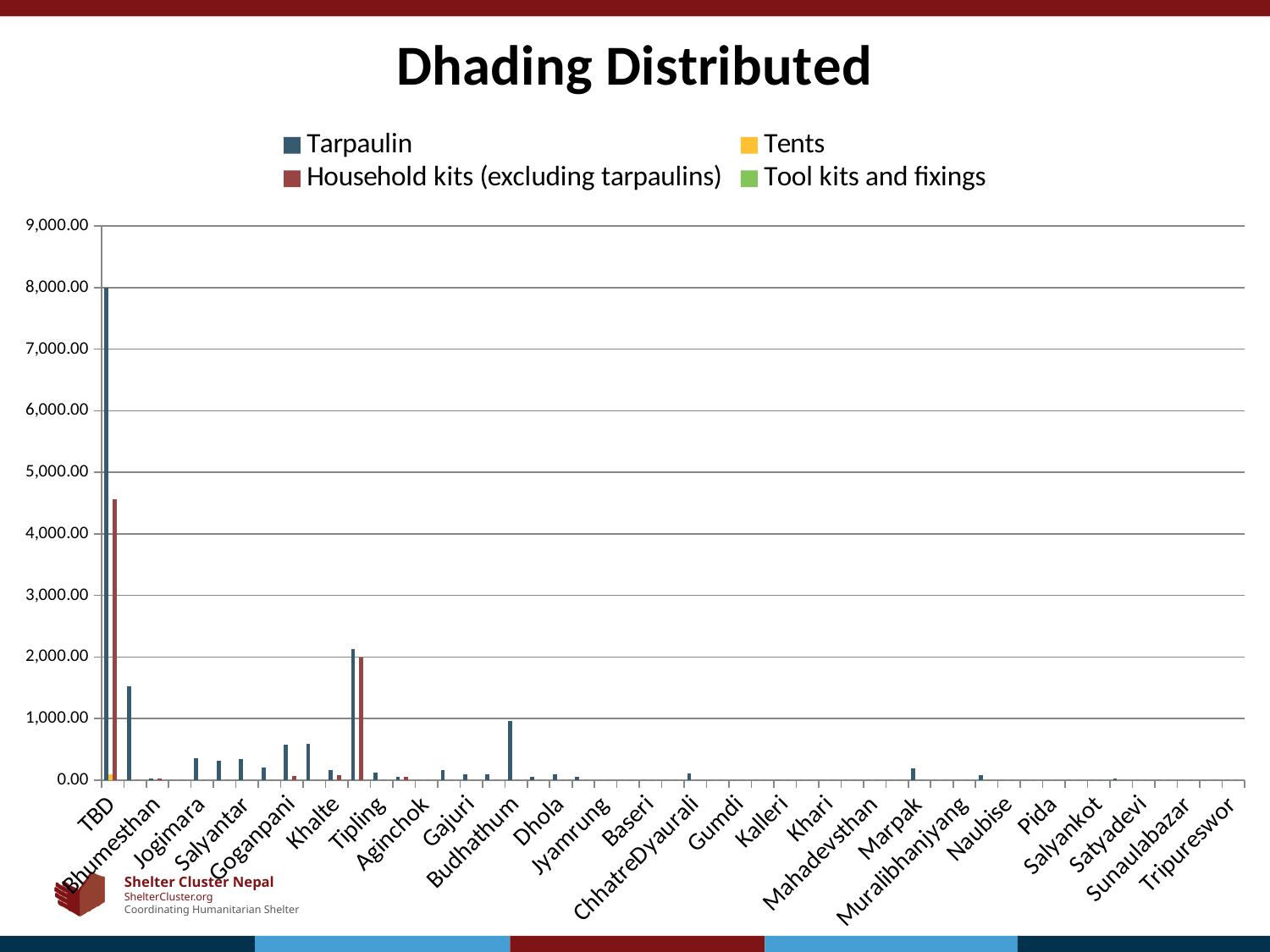
Is the Household kits (excluding tarpaulins) value for TBD greater or less than 5,000.00? less How many series does the legend list? 4 Is the Household kits (excluding tarpaulins) value for TBD greater or less than 4,000.00? greater What is the title of the chart? Dhading Distributed Is the Tarpaulin value for TBD greater or less than 7,000.00? greater Which series has the tallest bar on the chart? Tarpaulin For TBD, which is larger: the Tarpaulin value or the Household kits (excluding tarpaulins) value? Tarpaulin What kind of chart is shown on the slide? bar chart Which category has the highest Tarpaulin value? TBD Which has the larger Tarpaulin value: Bhumesthan or Tipling? Tipling